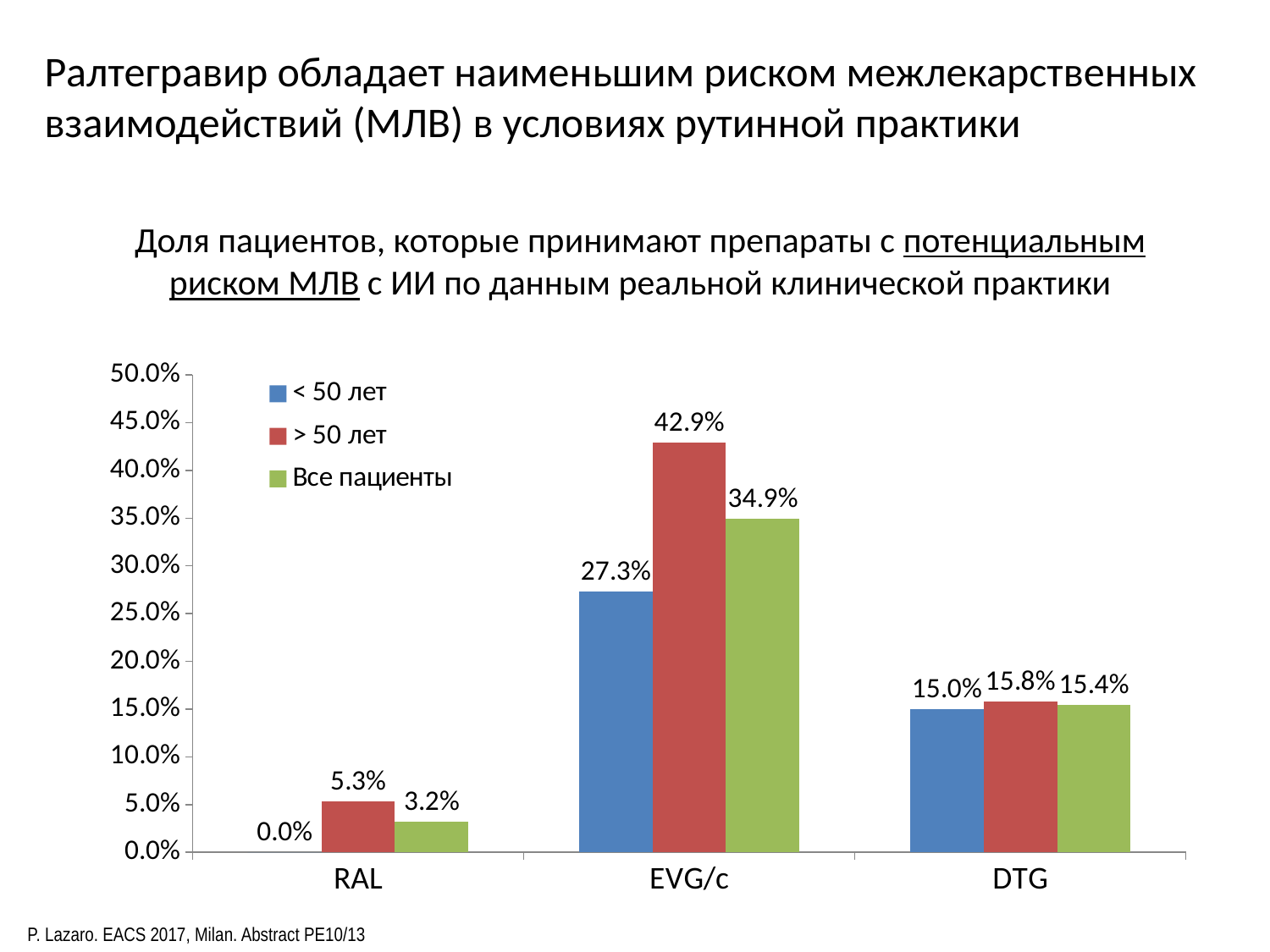
What is the difference between the "> 50 лет" and "< 50 лет" values for EVG/c? 15.6% What is the value for EVG/c in the "> 50 лет" series? 42.9% Which category has the highest value in the "Все пациенты" series? EVG/c What kind of chart is shown on the slide? Bar chart What is the value for DTG in the "< 50 лет" series? 15.0% What is the difference between the "Все пациенты" values for EVG/c and DTG? 19.5% Which is larger: the "> 50 лет" value for RAL or the "> 50 лет" value for DTG? DTG Which category has the lowest value in the "< 50 лет" series? RAL How many series does the legend list? 3 What is the value for RAL in the "Все пациенты" series? 3.2% How many categories are shown on the x axis? 3 Which colour represents the "> 50 лет" series? Red